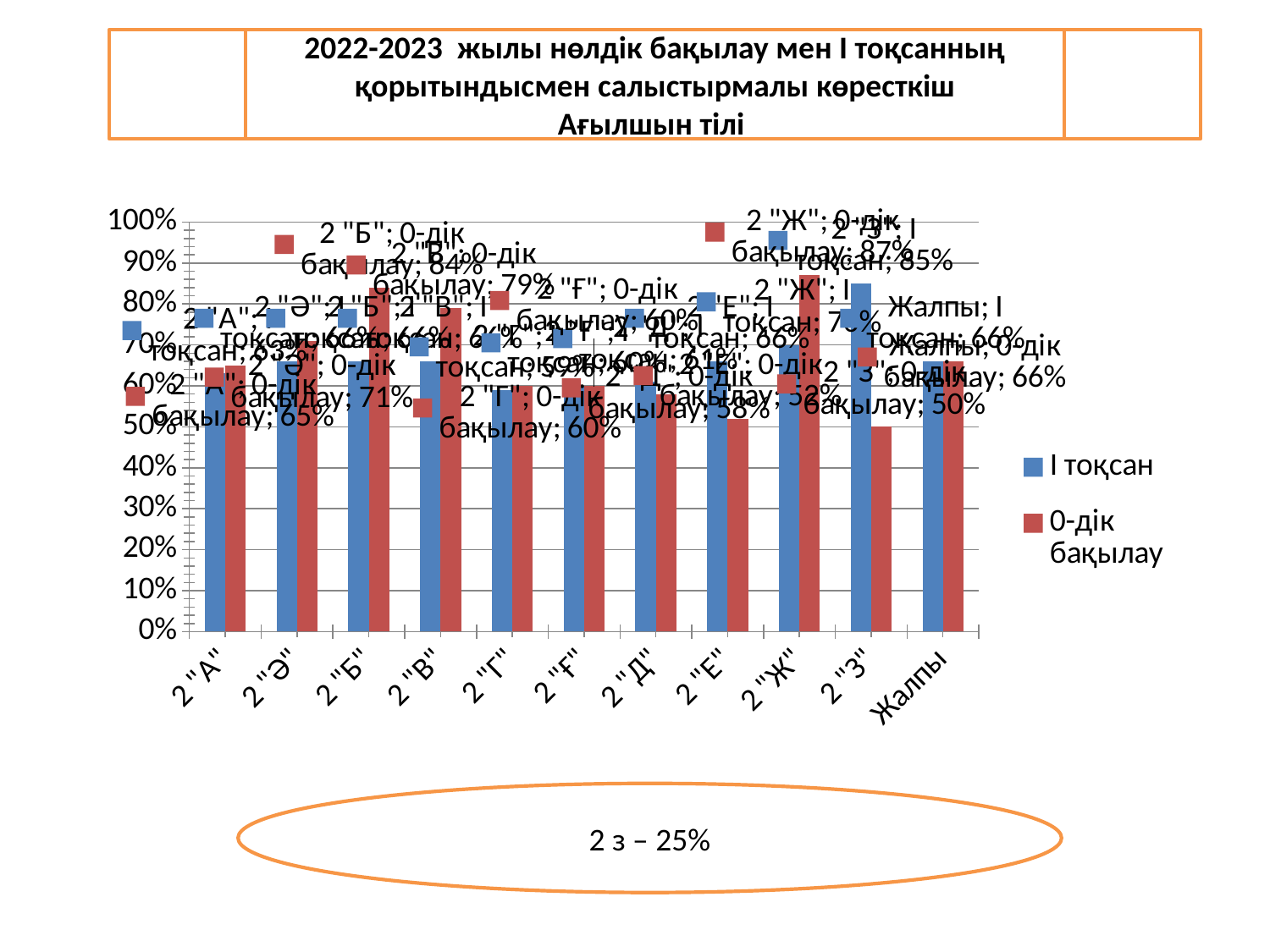
What is the difference between the I тоқсан and 0-дік бақылау values for 2 "З"? 35% Which category has the lowest 0-дік бақылау value? 2 "З" Which category has the highest 0-дік бақылау value? 2 "Ж" What is the 0-дік бақылау value for 2 "Ж"? 87% What is the 0-дік бақылау value for Жалпы? 66% What kind of chart is shown on the slide? bar chart How many series does the legend list? 2 What is the 0-дік бақылау value for 2 "З"? 50% How many categories are shown on the x axis? 11 Which is larger, the 0-дік бақылау value for 2 "Б" or for 2 "А"? 2 "Б" What is the I тоқсан value for 2 "З"? 85%